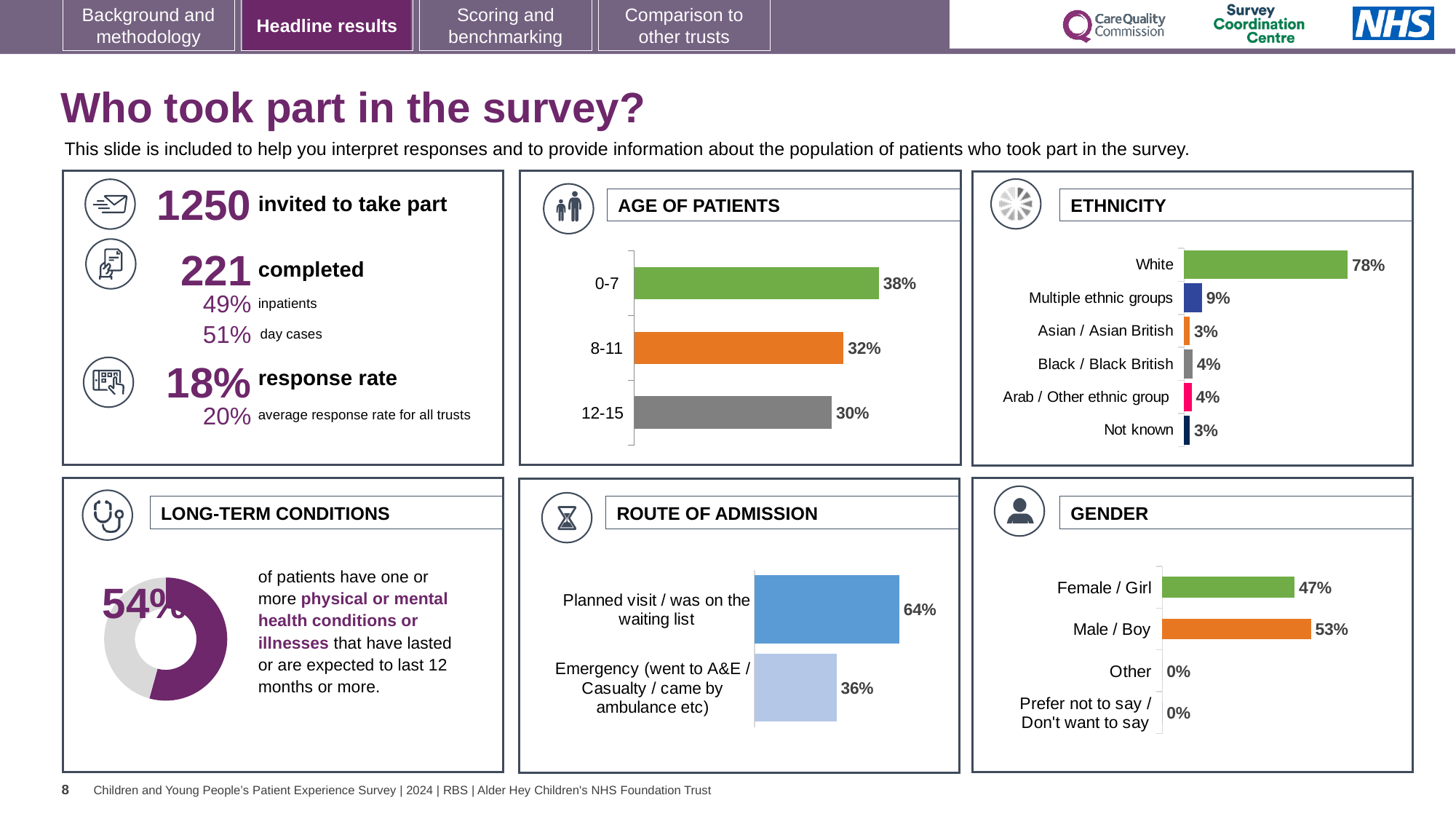
In the GENDER chart, what percentage of patients were Male / Boy? 53% What kind of chart is used in the LONG-TERM CONDITIONS panel? Doughnut chart In the ETHNICITY chart, how many ethnicity categories are shown? 6 In the ETHNICITY chart, what percentage of patients were White? 78% In the AGE OF PATIENTS chart, what percentage of patients were aged 0-7? 38% In the ETHNICITY chart, which is larger: Multiple ethnic groups or Asian / Asian British? Multiple ethnic groups In the GENDER chart, which category has the highest percentage? Male / Boy In the ROUTE OF ADMISSION chart, what percentage of patients had a planned visit / were on the waiting list? 64% In the LONG-TERM CONDITIONS chart, what percentage of patients have one or more long-term conditions? 54% In the AGE OF PATIENTS chart, what is the difference between the 0-7 and 12-15 percentages? 8% In the AGE OF PATIENTS chart, which age group has the lowest percentage? 12-15 In the ROUTE OF ADMISSION chart, what is the difference between the planned visit and emergency percentages? 28%